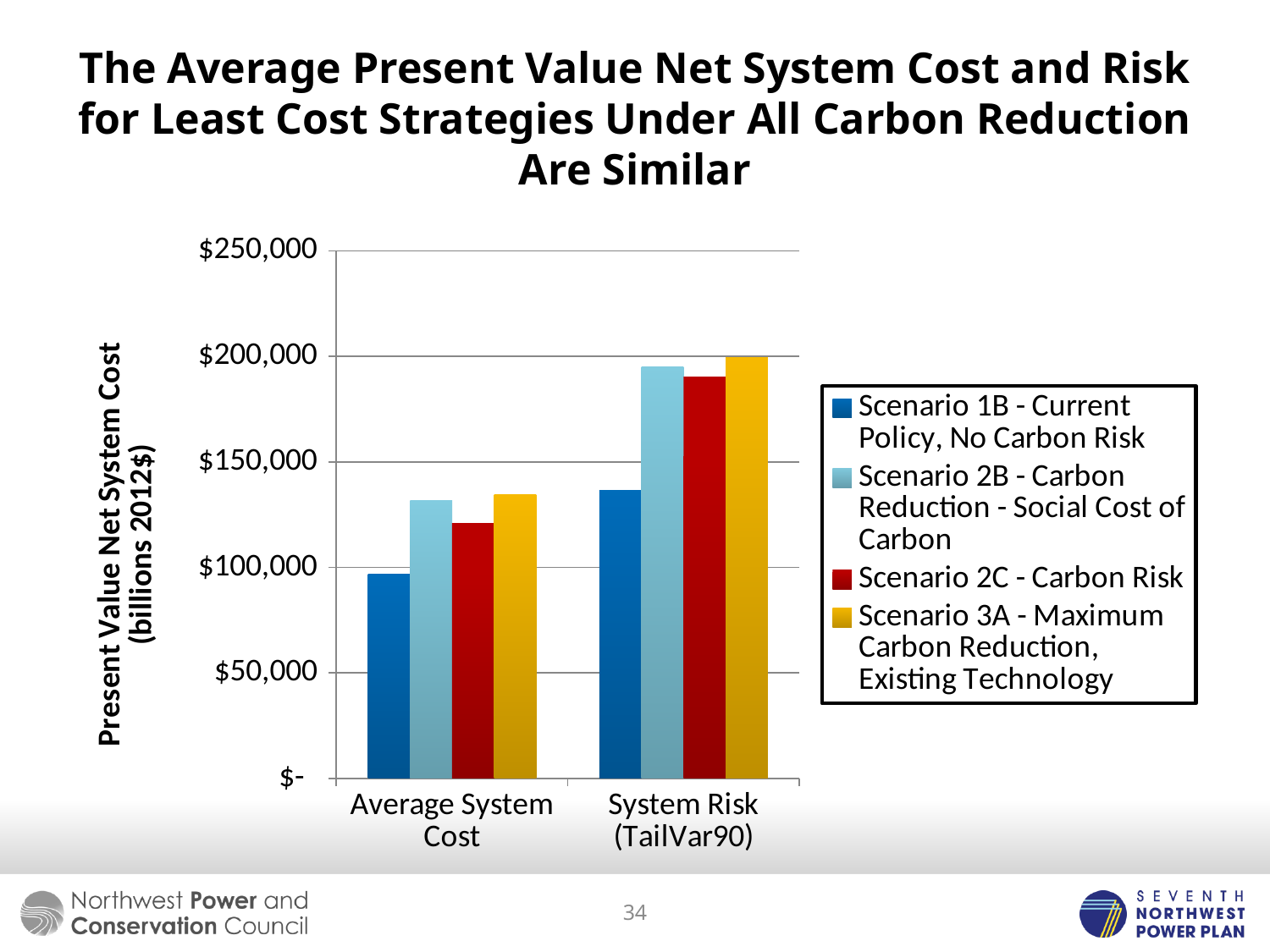
How many categories are shown on the x axis of the chart? 2 How many series does the chart's legend list? 4 Which scenario has the lowest value for Average System Cost? Scenario 1B - Current Policy, No Carbon Risk Which scenario has the lowest value for System Risk (TailVar90)? Scenario 1B - Current Policy, No Carbon Risk Is the System Risk (TailVar90) value for Scenario 2B - Carbon Reduction - Social Cost of Carbon greater or less than $150,000? greater What is the title of the chart's vertical axis? Present Value Net System Cost (billions 2012$) For Average System Cost, which is larger: the value for Scenario 1B - Current Policy, No Carbon Risk or the value for Scenario 2C - Carbon Risk? Scenario 2C - Carbon Risk Is the System Risk (TailVar90) value for Scenario 1B - Current Policy, No Carbon Risk greater or less than $150,000? less For System Risk (TailVar90), which is larger: the value for Scenario 1B - Current Policy, No Carbon Risk or the value for Scenario 3A - Maximum Carbon Reduction, Existing Technology? Scenario 3A - Maximum Carbon Reduction, Existing Technology What kind of chart is shown on the slide? bar chart Is the Average System Cost value for Scenario 2B - Carbon Reduction - Social Cost of Carbon greater or less than $100,000? greater